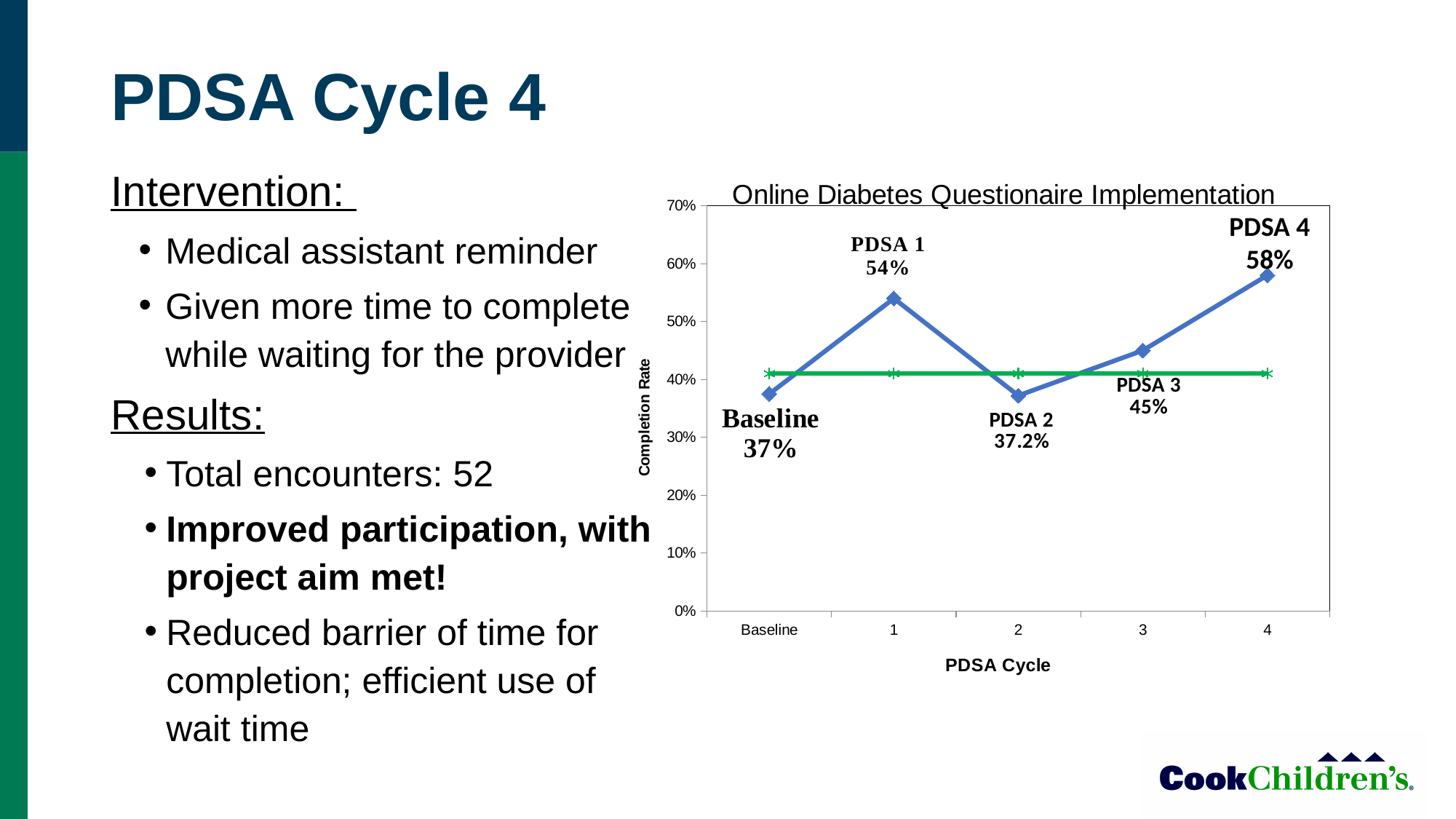
What is the difference in completion rate between PDSA 4 and PDSA 1? 4 percentage points What is the difference in completion rate between PDSA 1 and Baseline? 17 percentage points What is the completion rate for PDSA 1? 54% What is the completion rate for PDSA 4? 58% What type of chart is shown on the slide? Line chart What is the completion rate for PDSA 3? 45% Is the value of the flat green line greater or less than 50%? less What is the completion rate at Baseline? 37% Which has a higher completion rate, PDSA 1 or PDSA 3? PDSA 1 Which PDSA cycle has the highest completion rate? PDSA 4 What is the completion rate for PDSA 2? 37.2% How many data points are plotted on the blue completion rate line? 5